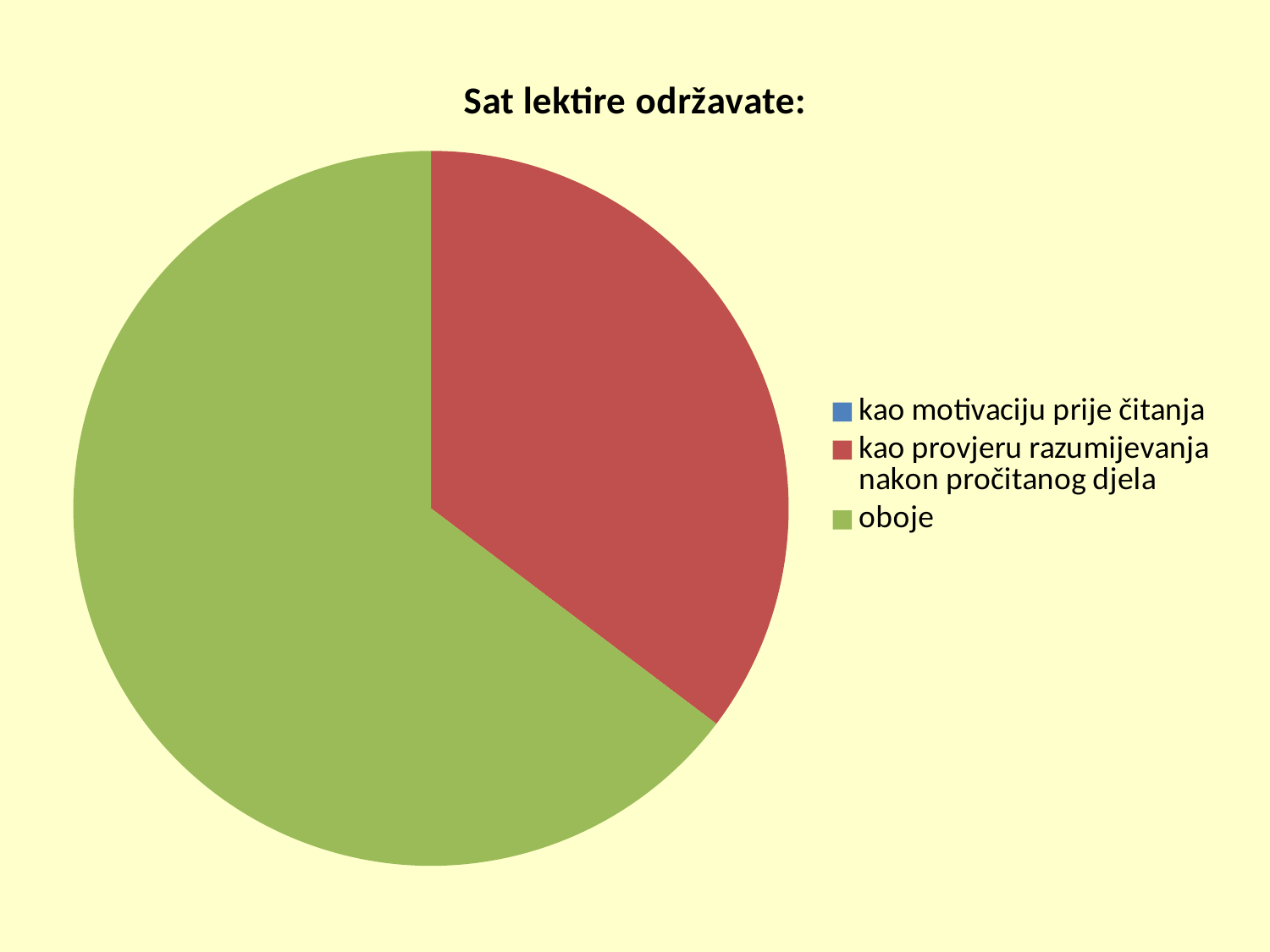
How many slices are visible in the pie? 2 Does the slice for "oboje" take up more or less than half of the pie? more Which category has the largest slice of the pie? oboje What colour is the slice for "oboje"? green What is the title of the chart? Sat lektire održavate: Which is larger: the slice for "oboje" or the slice for "kao provjeru razumijevanja nakon pročitanog djela"? oboje Which legend entry has no visible slice in the pie? kao motivaciju prije čitanja What kind of chart is shown on the slide? pie chart Does the slice for "kao provjeru razumijevanja nakon pročitanog djela" take up more or less than half of the pie? less How many entries does the legend list? 3